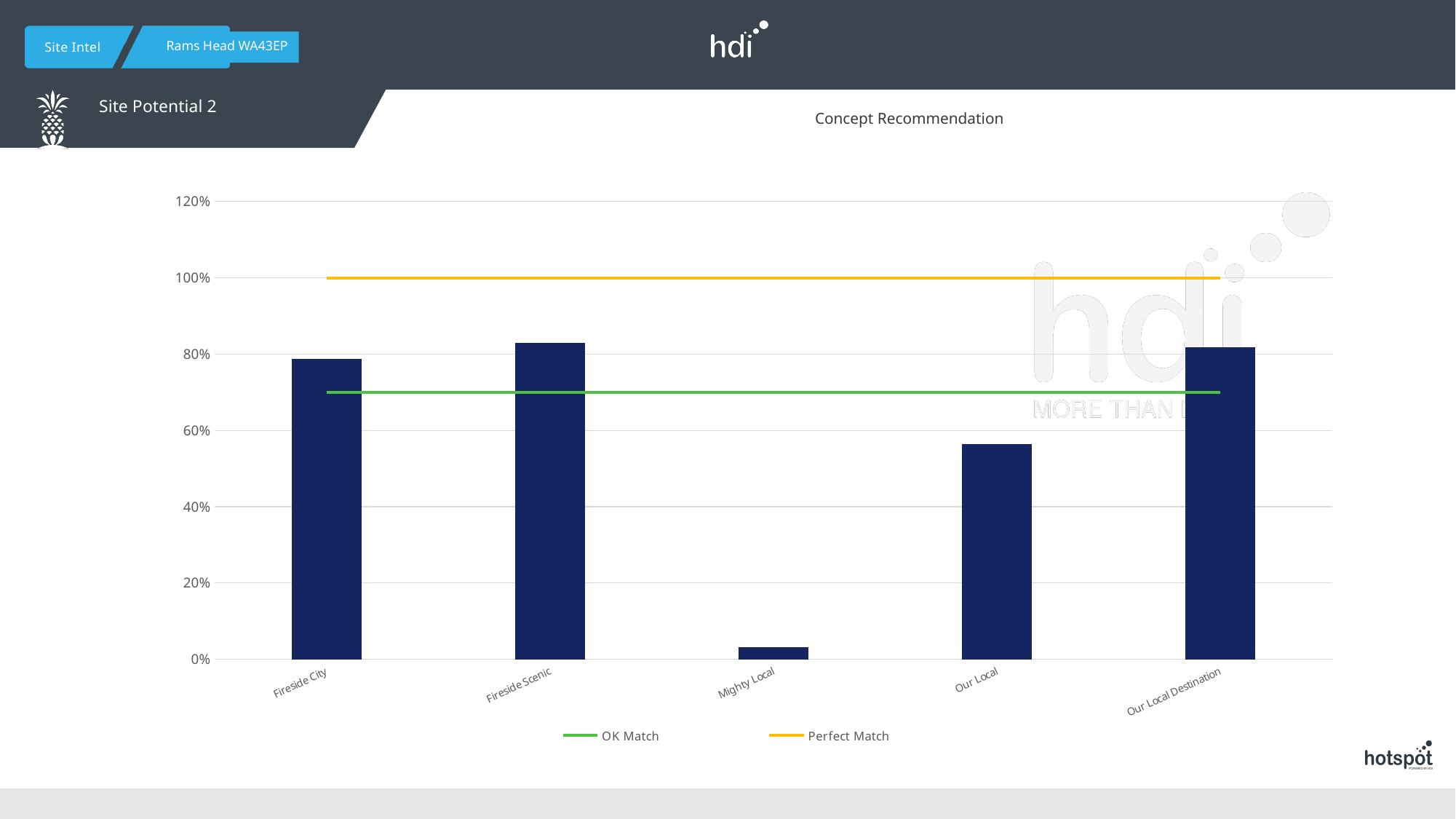
Is the value for Our Local greater or less than 40%? greater What is the title shown above the chart? Concept Recommendation Which is larger, the value for Mighty Local or the value for Our Local? Our Local Is the value for Fireside City greater or less than 60%? greater At what level on the y axis is the Perfect Match line drawn? 100% How many categories are shown on the x axis of the chart? 5 Which category has the lowest bar in the chart? Mighty Local Is the value for Mighty Local greater or less than 20%? less What kind of chart is shown on the slide? Bar chart How many series does the chart legend list? 2 Which is larger, the value for Fireside City or the value for Our Local? Fireside City